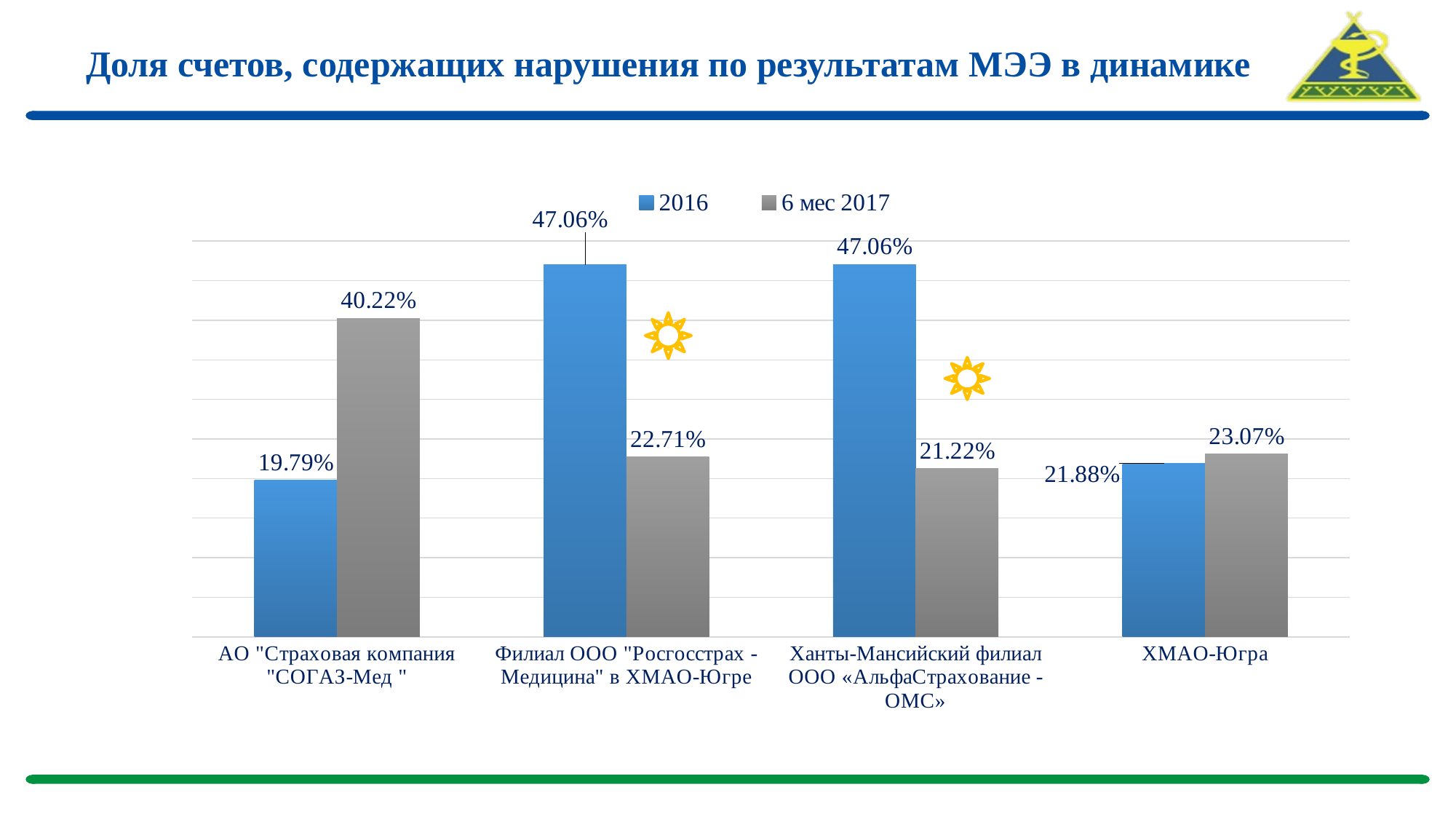
What is the 6 мес 2017 value for Филиал ООО "Росгосстрах - Медицина" в ХМАО-Югре? 22.71% Which category has the lowest 2016 value? АО "Страховая компания "СОГАЗ-Мед" What is the title of the chart on the slide? Доля счетов, содержащих нарушения по результатам МЭЭ в динамике Which category has the highest 6 мес 2017 value? АО "Страховая компания "СОГАЗ-Мед" What type of chart is shown on the slide? bar chart What is the difference between the 6 мес 2017 and 2016 values for АО "Страховая компания "СОГАЗ-Мед"? 20.43% What is the 2016 value for АО "Страховая компания "СОГАЗ-Мед"? 19.79% For Ханты-Мансийский филиал ООО «АльфаСтрахование - ОМС», which is larger: the 2016 value or the 6 мес 2017 value? 2016 What is the 2016 value for ХМАО-Югра? 21.88% How many categories are shown on the x axis? 4 How many series does the legend list? 2 What is the 6 мес 2017 value for Ханты-Мансийский филиал ООО «АльфаСтрахование - ОМС»? 21.22%